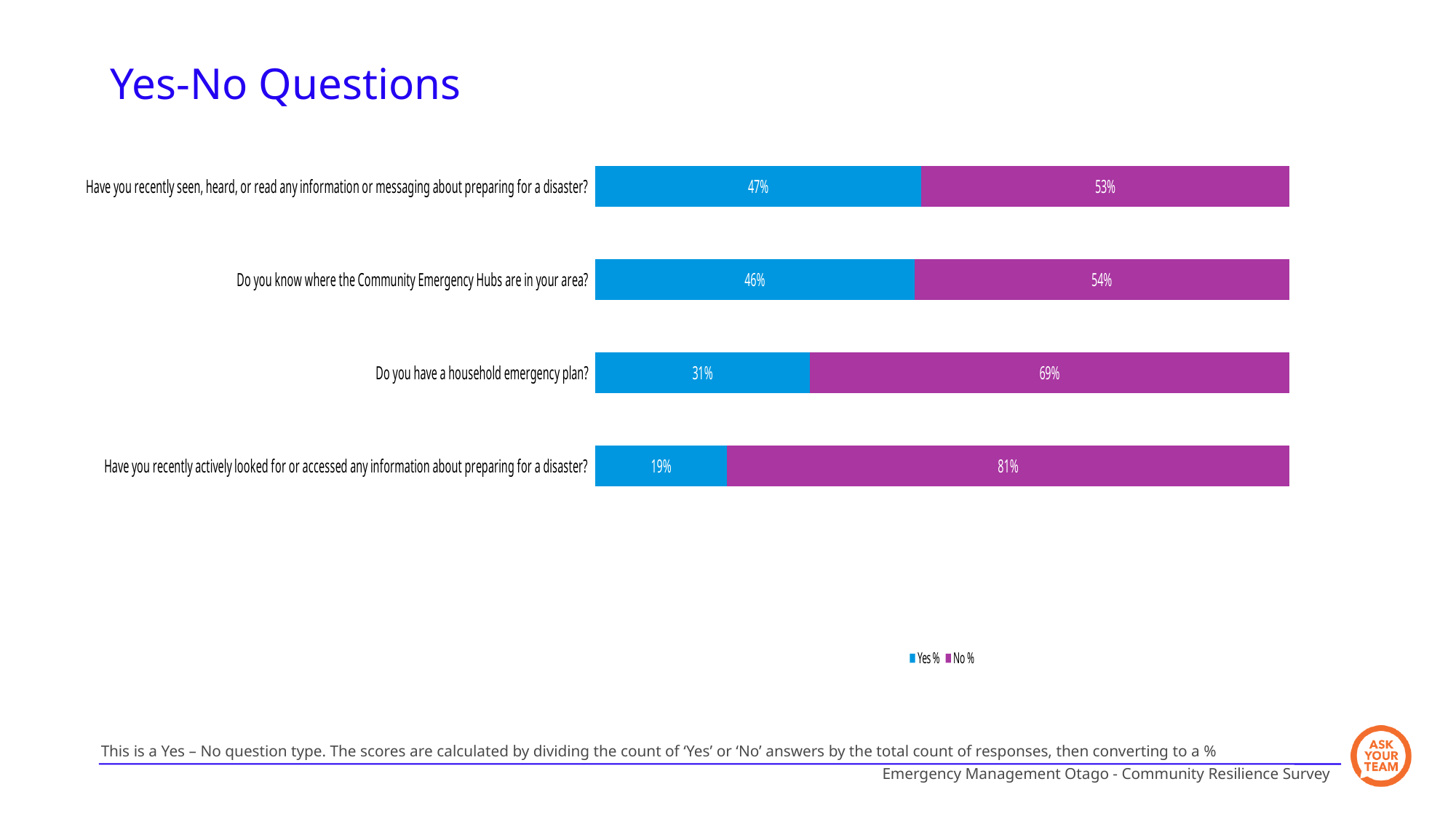
Which is larger for "Do you know where the Community Emergency Hubs are in your area?": the Yes % or the No %? No % What is the difference between the No % and the Yes % for "Do you have a household emergency plan?" 38% What kind of chart is shown on the slide? Stacked bar chart What is the No % for "Have you recently seen, heard, or read any information or messaging about preparing for a disaster?" 53% Which question has the lowest Yes %? Have you recently actively looked for or accessed any information about preparing for a disaster? How many questions are plotted in the chart? 4 What is the Yes % for "Do you have a household emergency plan?" 31% What is the No % for "Do you know where the Community Emergency Hubs are in your area?" 54% What is the Yes % for "Have you recently actively looked for or accessed any information about preparing for a disaster?" 19% What colour represents the No % series in the chart? Purple Which question has the highest Yes %? Have you recently seen, heard, or read any information or messaging about preparing for a disaster? How many series does the legend list? 2